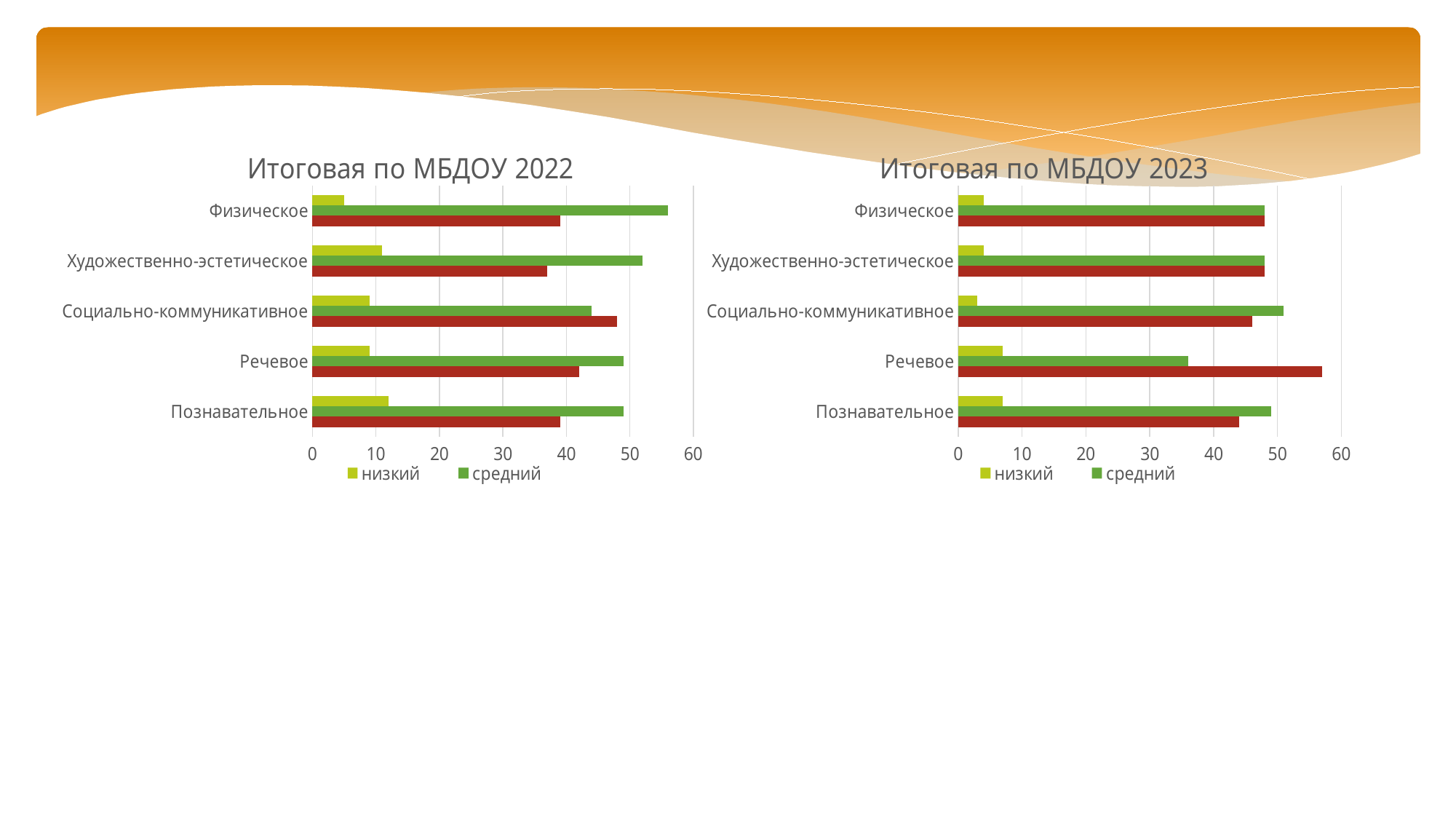
In the "Итоговая по МБДОУ 2022" chart, which category has the highest value for the "средний" series? Физическое In the "Итоговая по МБДОУ 2022" chart, which is larger for the "средний" series: Физическое or Социально-коммуникативное? Физическое In the "Итоговая по МБДОУ 2023" chart, is the "средний" value for Речевое greater or less than 40? less In the "Итоговая по МБДОУ 2023" chart, which is larger for the "средний" series: Речевое or Познавательное? Познавательное What is the title of the chart on the right side of the slide? Итоговая по МБДОУ 2023 In the "Итоговая по МБДОУ 2023" chart, which category has the lowest value for the "средний" series? Речевое In the "Итоговая по МБДОУ 2022" chart, which category has the lowest value for the "низкий" series? Физическое What kind of chart is "Итоговая по МБДОУ 2022"? bar chart In the "Итоговая по МБДОУ 2023" chart, is the "низкий" value for Социально-коммуникативное greater or less than 10? less In the "Итоговая по МБДОУ 2022" chart, is the "низкий" value for Познавательное greater or less than 10? greater How many categories are shown on the "Итоговая по МБДОУ 2023" chart? 5